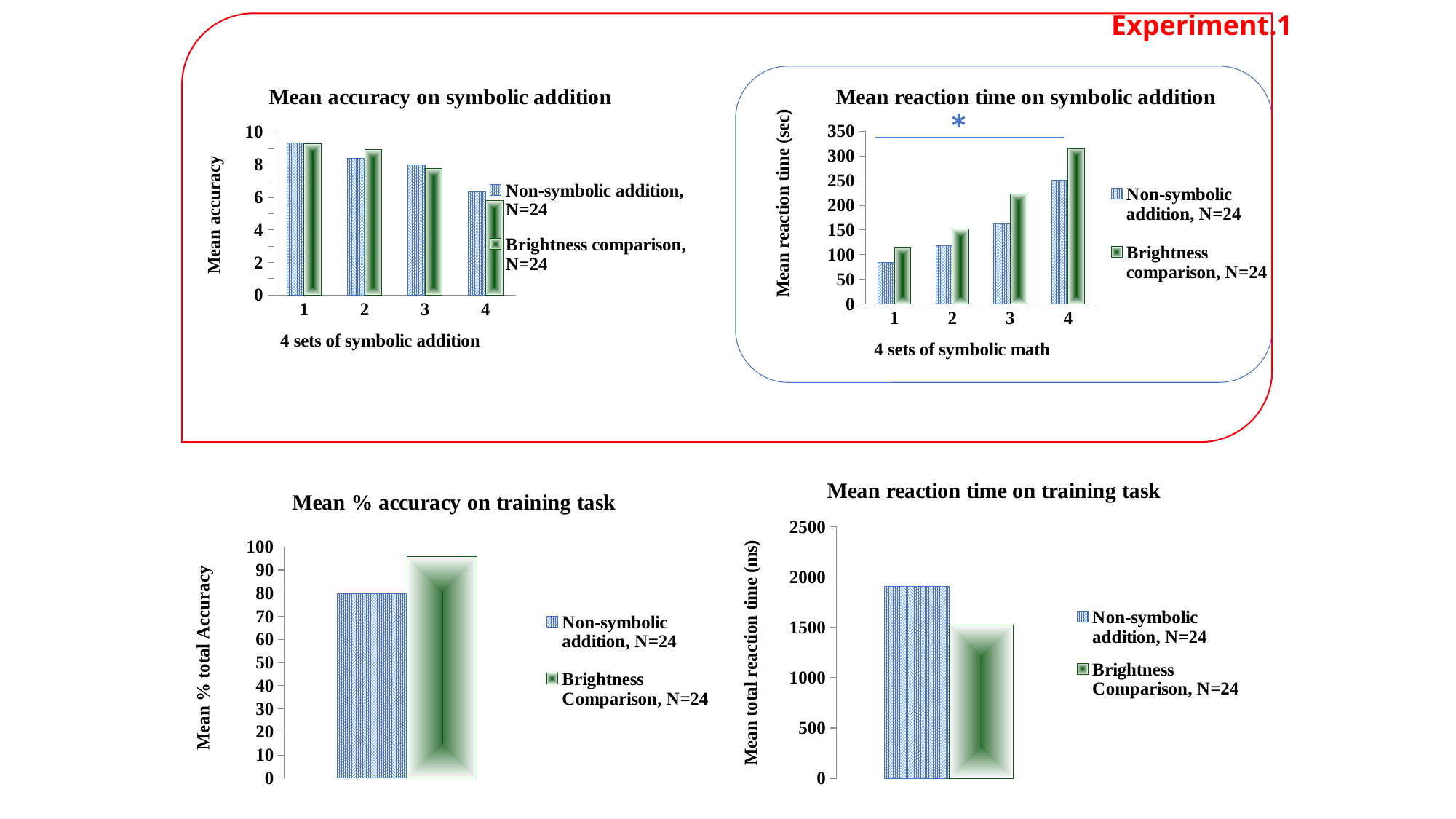
In the 'Mean reaction time on symbolic addition' chart, do the values for Brightness comparison rise or fall from set 1 to set 4? rise In the 'Mean % accuracy on training task' chart, which series has the higher value? Brightness Comparison, N=24 In the 'Mean reaction time on symbolic addition' chart, is the value for Brightness comparison at set 4 greater or less than 300? greater What kind of chart is 'Mean reaction time on training task'? bar chart In the 'Mean accuracy on symbolic addition' chart, is the value for Non-symbolic addition at set 1 greater or less than 8? greater In the 'Mean reaction time on symbolic addition' chart, which series has the larger value at set 3? Brightness comparison, N=24 In the 'Mean % accuracy on training task' chart, is the value for Brightness Comparison greater or less than 90? greater In the 'Mean accuracy on symbolic addition' chart, how many series does the legend list? 2 In the 'Mean accuracy on symbolic addition' chart, how many sets are shown on the x axis? 4 In the 'Mean accuracy on symbolic addition' chart, do the values for Non-symbolic addition rise or fall from set 1 to set 4? fall